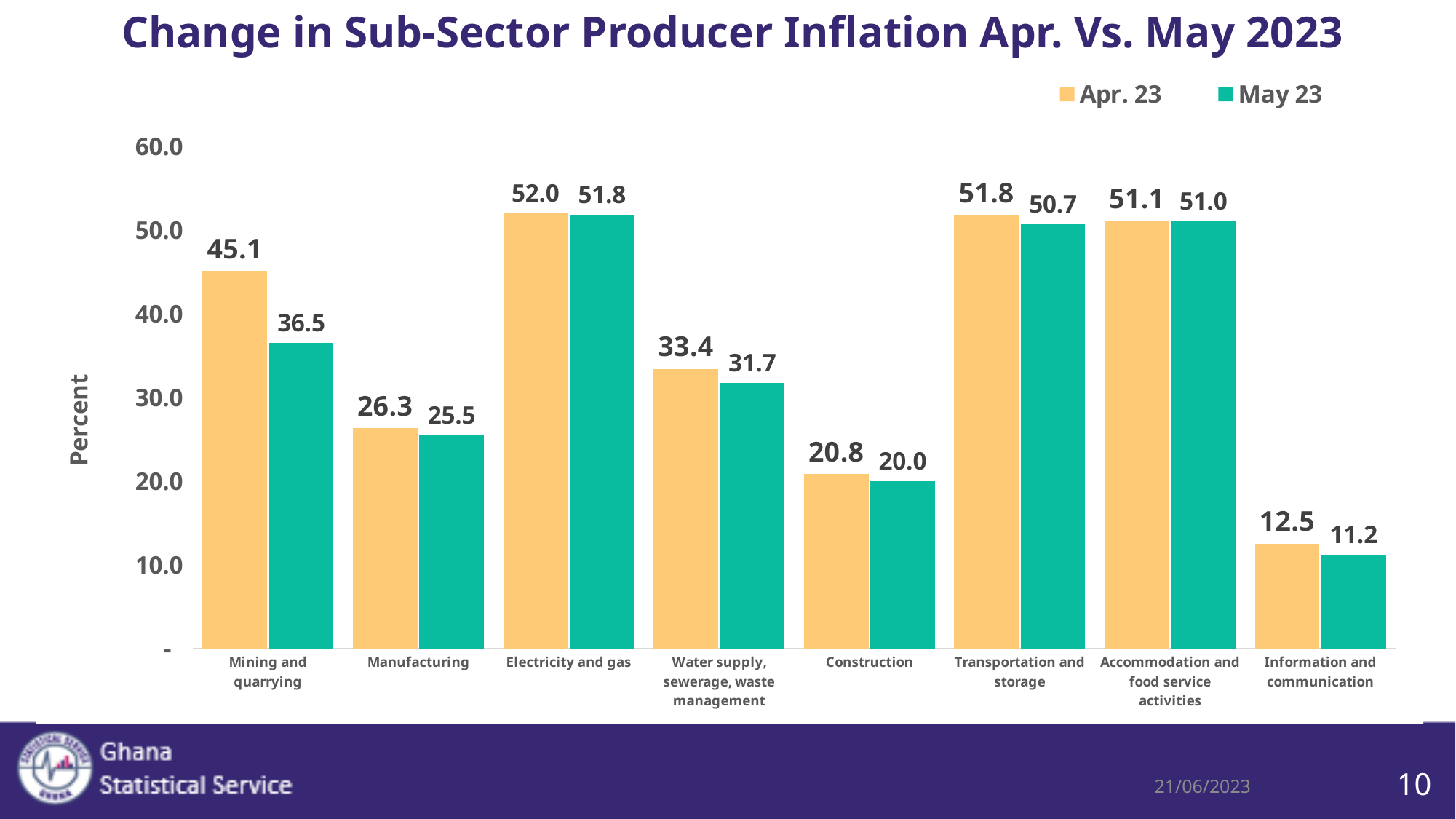
What is the May 23 value for Information and communication? 11.2 What is the difference between the Apr. 23 and May 23 values for Construction? 0.8 How many series does the legend list? 2 What kind of chart is shown on the slide? Bar chart Which sub-sector has the lowest May 23 value? Information and communication What is the difference between the Apr. 23 and May 23 values for Mining and quarrying? 8.6 Which is larger: the May 23 value for Manufacturing or the May 23 value for Construction? Manufacturing What is the label on the vertical axis? Percent What is the May 23 value for Water supply, sewerage, waste management? 31.7 What is the Apr. 23 value for Mining and quarrying? 45.1 Which sub-sector has the highest Apr. 23 value? Electricity and gas How many sub-sectors are shown on the x axis? 8